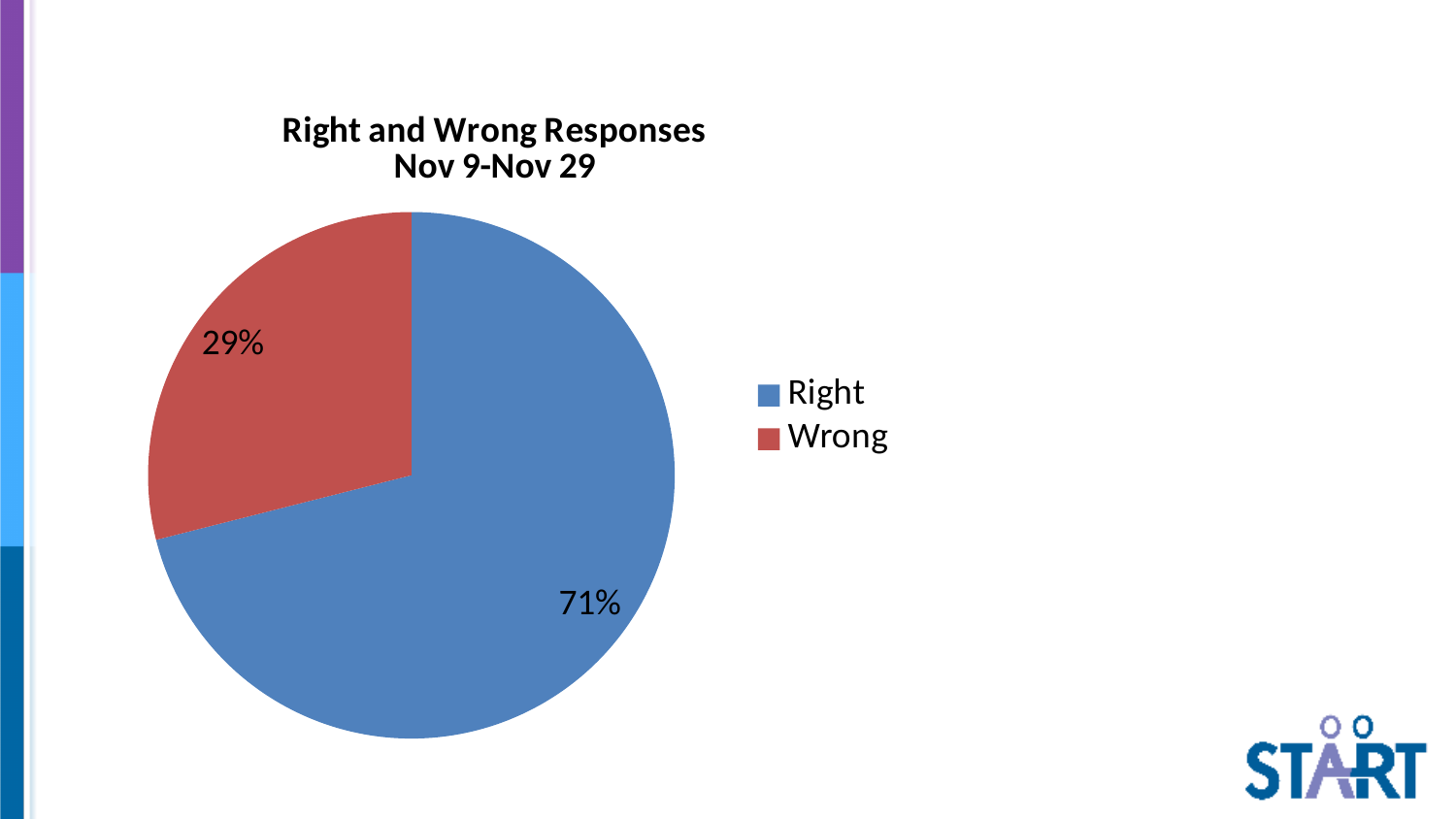
What is the difference in percentage points between the Right and Wrong shares? 42 Which category has the largest share of the pie? Right What is the title of the chart? Right and Wrong Responses Nov 9-Nov 29 What percentage of responses were Wrong? 29% What share of the pie does the Right slice take? 71% Which is larger, the share of Right responses or the share of Wrong responses? Right How many categories does the pie chart show? 2 Which category has the smallest share of the pie? Wrong What kind of chart is shown on the slide? Pie chart What percentage of responses were Right? 71% How many entries does the legend list? 2 What colour is the Wrong slice? Red